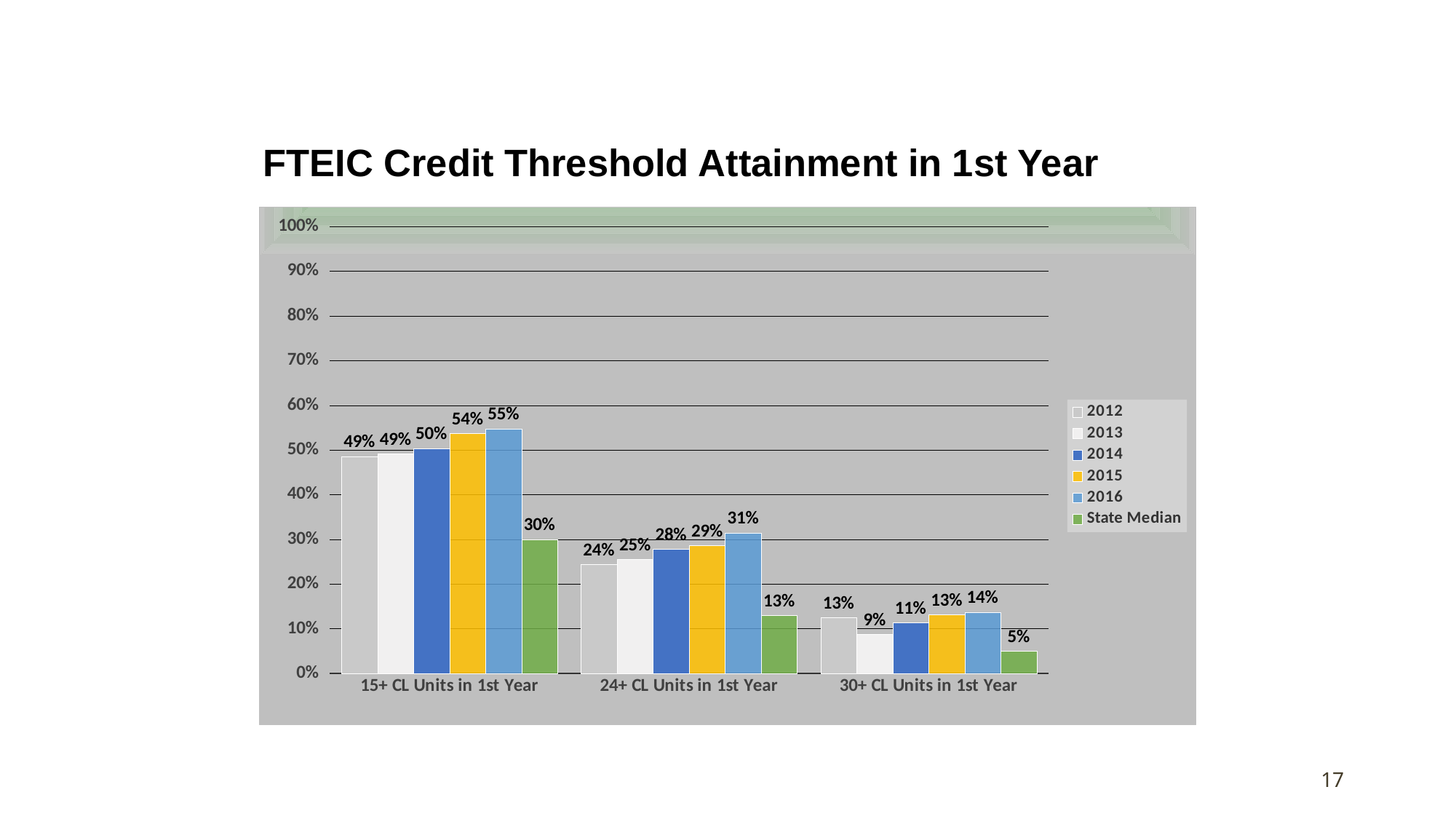
What is the difference between the 2016 value and the State Median value for 15+ CL Units in 1st Year? 25% What kind of chart is shown on the slide? Bar chart Which year has the highest value for 24+ CL Units in 1st Year? 2016 Which is larger for 30+ CL Units in 1st Year: the 2012 value or the 2014 value? 2012 What is the 2016 value for 15+ CL Units in 1st Year? 55% What is the title of the chart? FTEIC Credit Threshold Attainment in 1st Year How many series does the legend list? 6 Which series has the lowest value for 30+ CL Units in 1st Year? State Median What is the State Median value for 24+ CL Units in 1st Year? 13% What is the 2013 value for 30+ CL Units in 1st Year? 9% Do the 2015 values rise or fall across the categories from 15+ to 30+ CL Units in 1st Year? Fall How many categories are shown on the x axis? 3